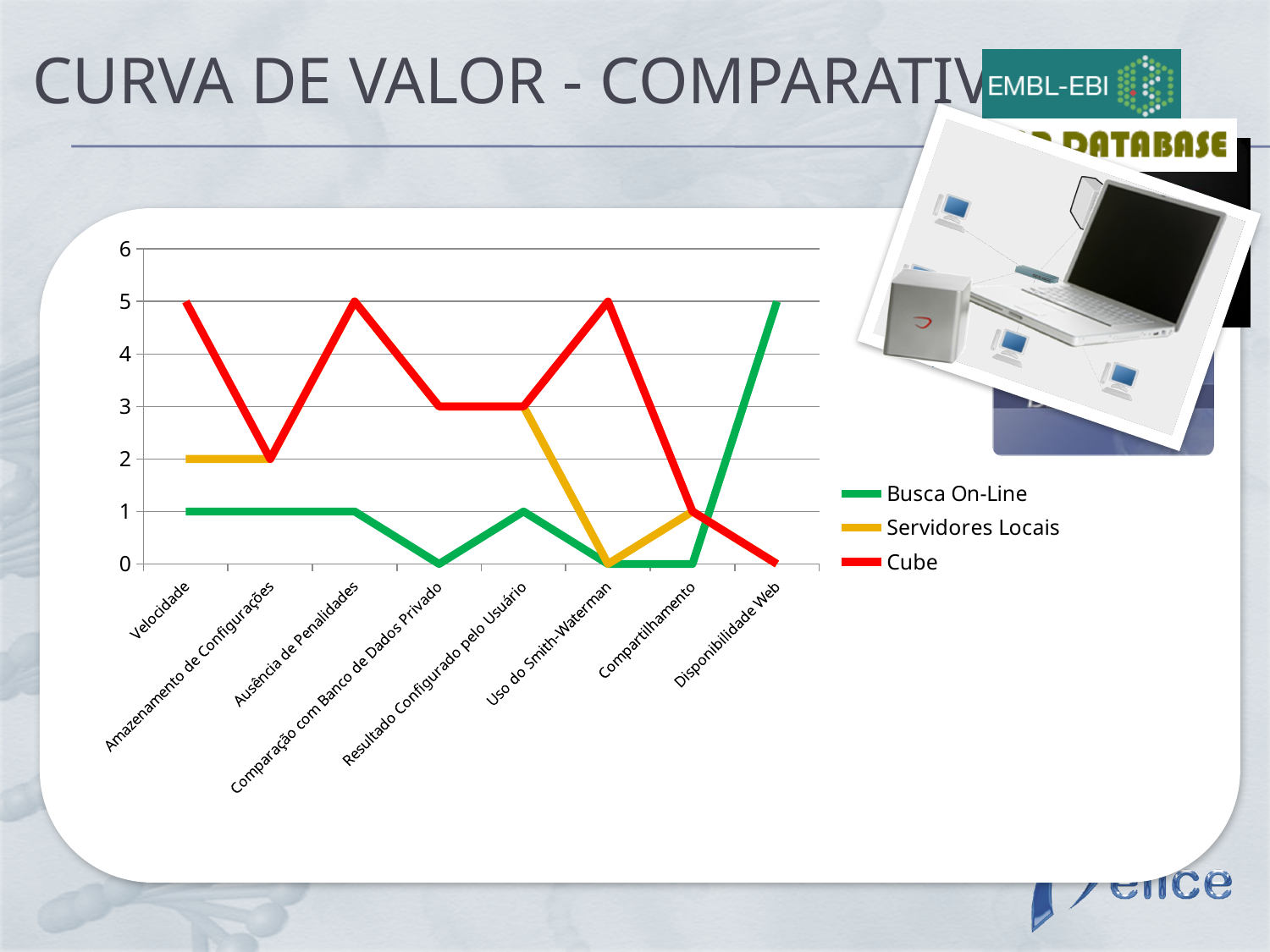
What is the value of Cube for Velocidade? 5 How many categories are shown on the x axis? 8 What is the value of Servidores Locais for Uso do Smith-Waterman? 0 What type of chart is shown on the slide? Line chart What is the value of Busca On-Line for Comparação com Banco de Dados Privado? 0 What is the value of Cube for Compartilhamento? 1 What is the value of Busca On-Line for Disponibilidade Web? 5 What is the difference between Cube and Busca On-Line for Velocidade? 4 How many series does the legend list? 3 Which colour represents the Cube series in the legend? Red For which category does Busca On-Line reach its highest value? Disponibilidade Web For which category does Cube have its lowest value? Disponibilidade Web